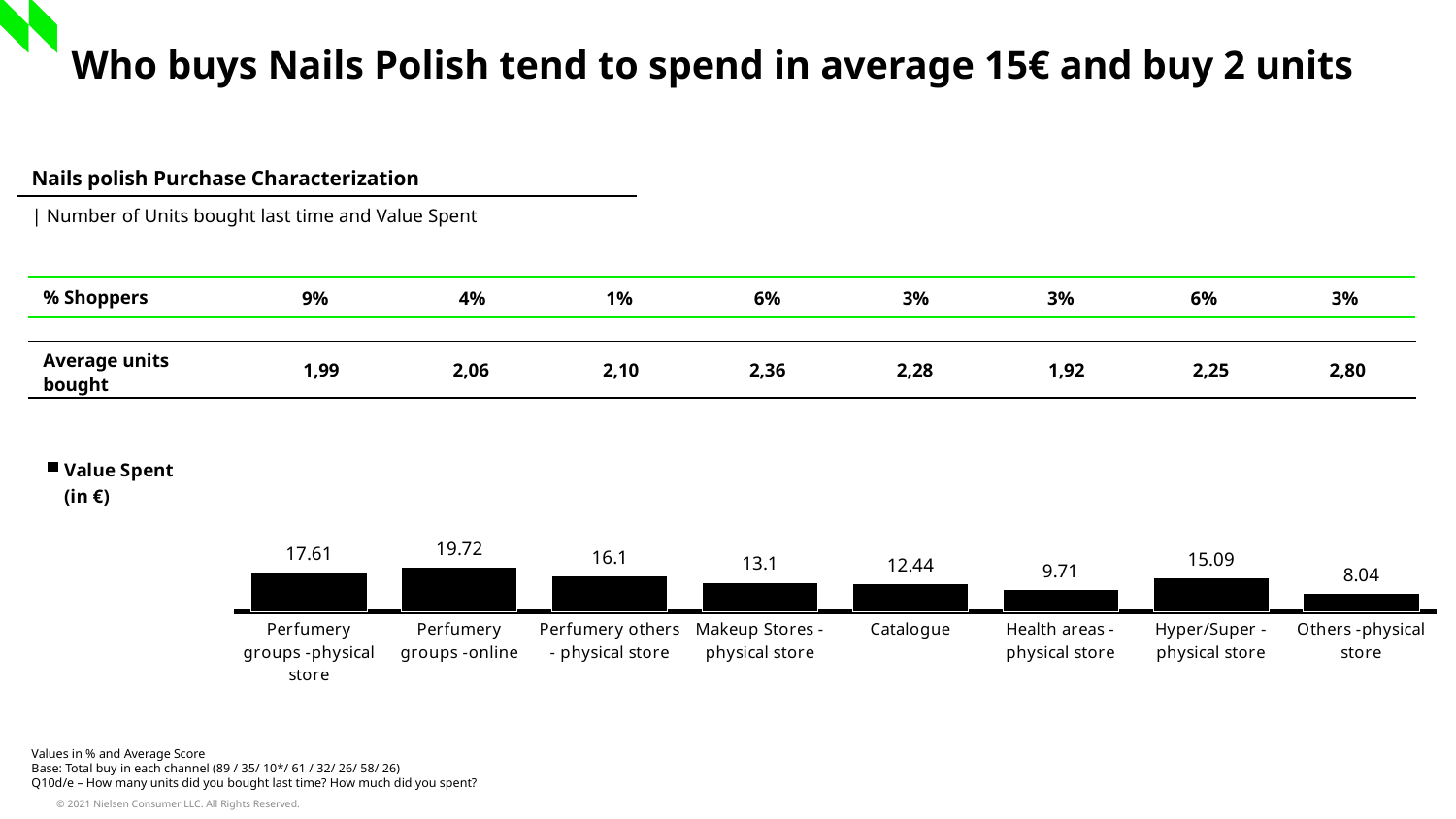
What is the Value Spent (in €) for Catalogue? 12.44 What is the difference in Value Spent between Perfumery groups - physical store and Makeup Stores - physical store? 4.51 What is the legend entry of the chart? Value Spent (in €) Which has a higher Value Spent: Perfumery others - physical store or Health areas - physical store? Perfumery others - physical store What is the difference in Value Spent between Perfumery groups - online and Others - physical store? 11.68 Which channel has the highest Value Spent (in €)? Perfumery groups - online What is the Value Spent (in €) for Hyper/Super - physical store? 15.09 How many channels are shown in the Value Spent chart? 8 What is the Value Spent (in €) for Perfumery groups - online? 19.72 Which channel has the lowest Value Spent (in €)? Others - physical store How many series does the legend of the Value Spent chart list? 1 What kind of chart is used to show Value Spent (in €)? Bar chart